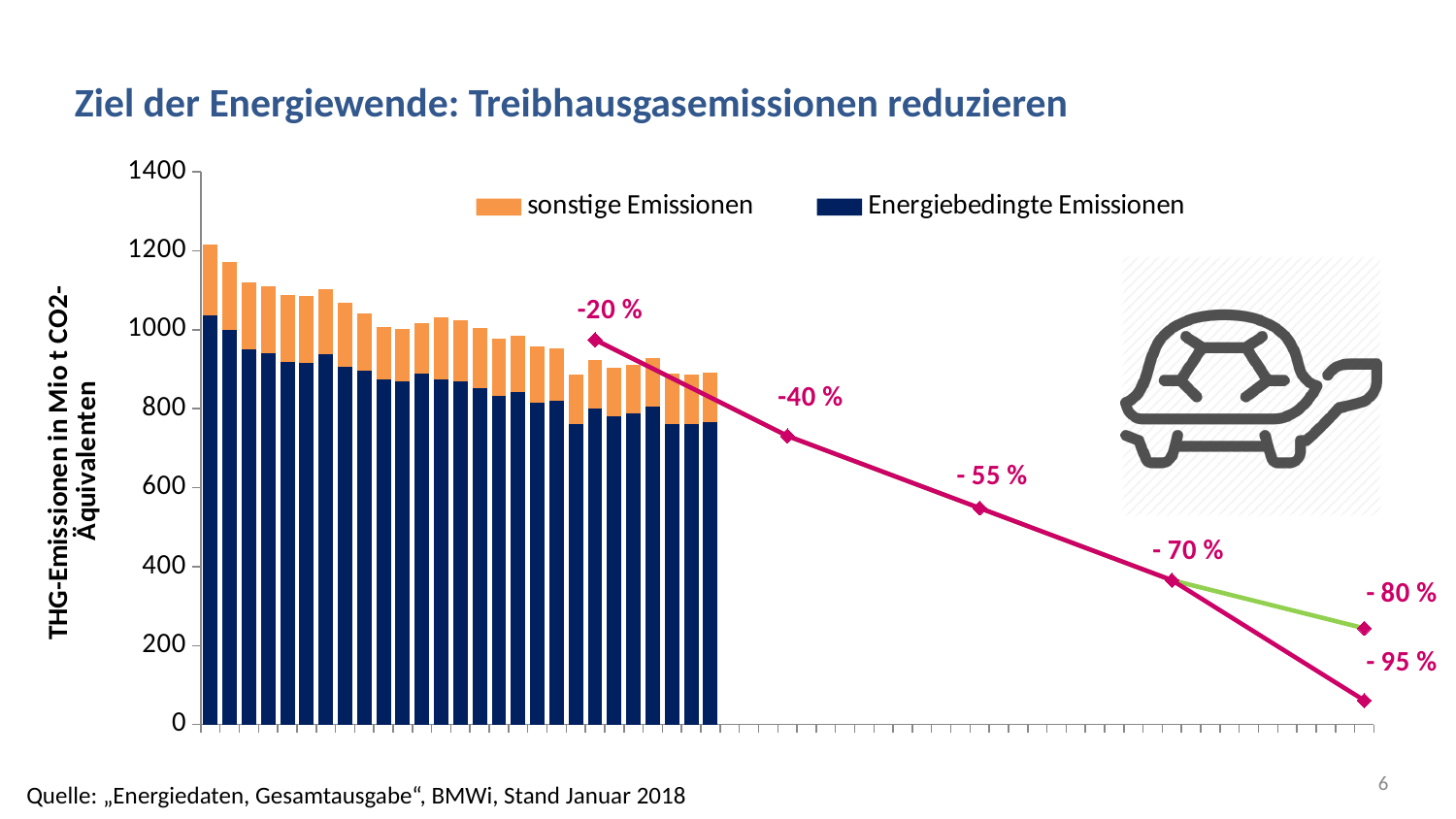
What label is shown at the lowest end point of the line? - 95 % What kind of chart is shown on the slide? stacked bar chart with a line Is the value at the point labelled - 80 % greater or less than 200? greater What is the title of the slide? Ziel der Energiewende: Treibhausgasemissionen reduzieren What label is shown at the first point of the line? -20 % How many series does the legend list? 2 Do the stacked bars generally rise or fall from left to right along the x axis? fall Is the total of the leftmost stacked bar greater or less than 1000? greater What are the two series named in the legend? sonstige Emissionen, Energiebedingte Emissionen How many labelled points are there on the line? 6 Which stacked bar is the highest? the leftmost bar Is the value at the point labelled -40 % greater or less than 800? less